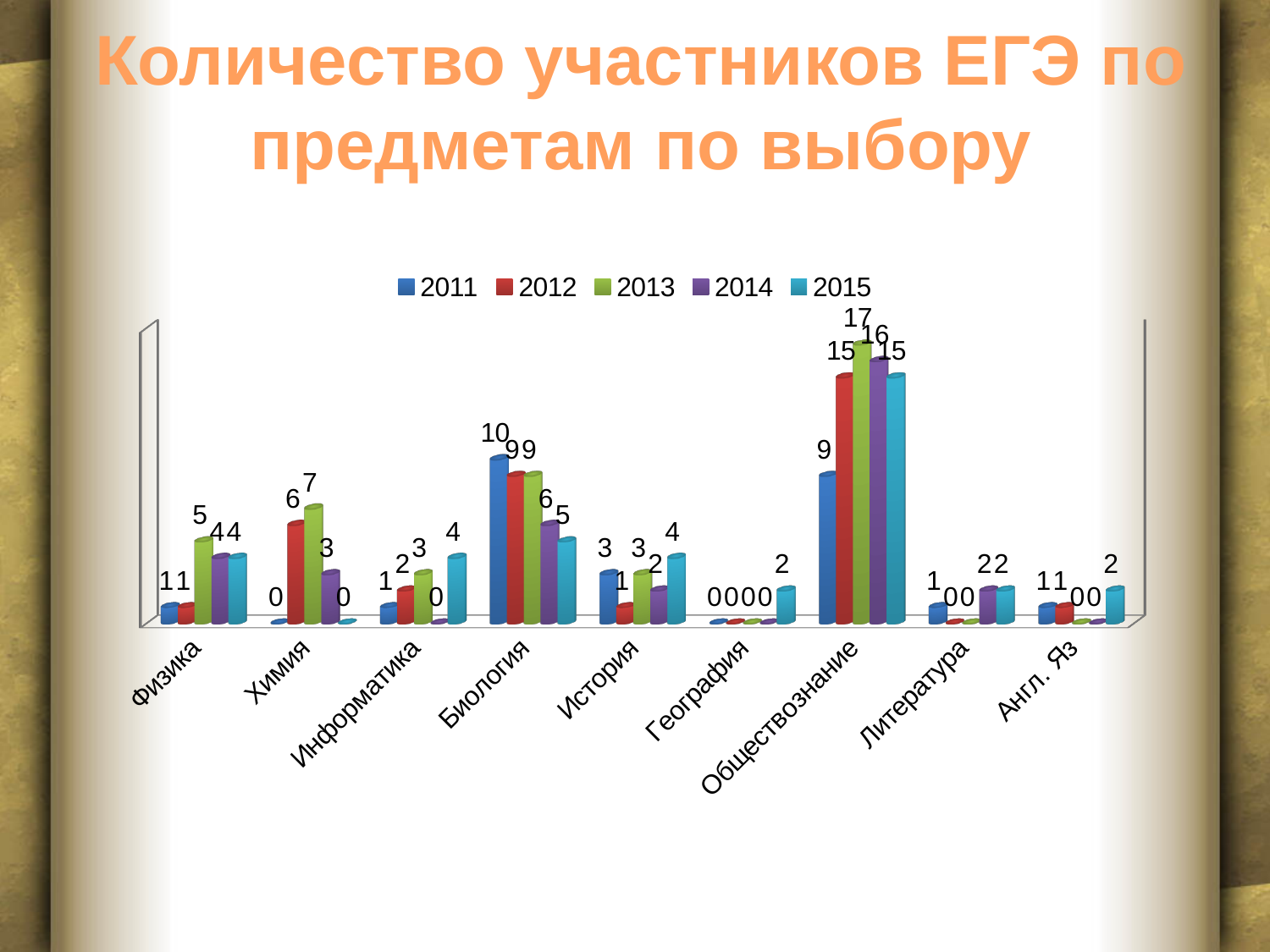
What is the value for География in 2015? 2 Which series is shown in green in the legend? 2013 How many series does the legend list? 5 What is the value for Обществознание in 2013? 17 What is the difference between the 2013 and 2011 values for Обществознание? 8 How many subject categories are shown on the x axis? 9 Which subject has the highest value in 2015? Обществознание Which is larger, the 2015 value for Информатика or the 2015 value for Физика? Neither; they are equal (both 4) What is the value for Биология in 2011? 10 What is the value for Химия in 2012? 6 Which year has the lowest value for Обществознание? 2011 What kind of chart is shown on the slide? bar chart